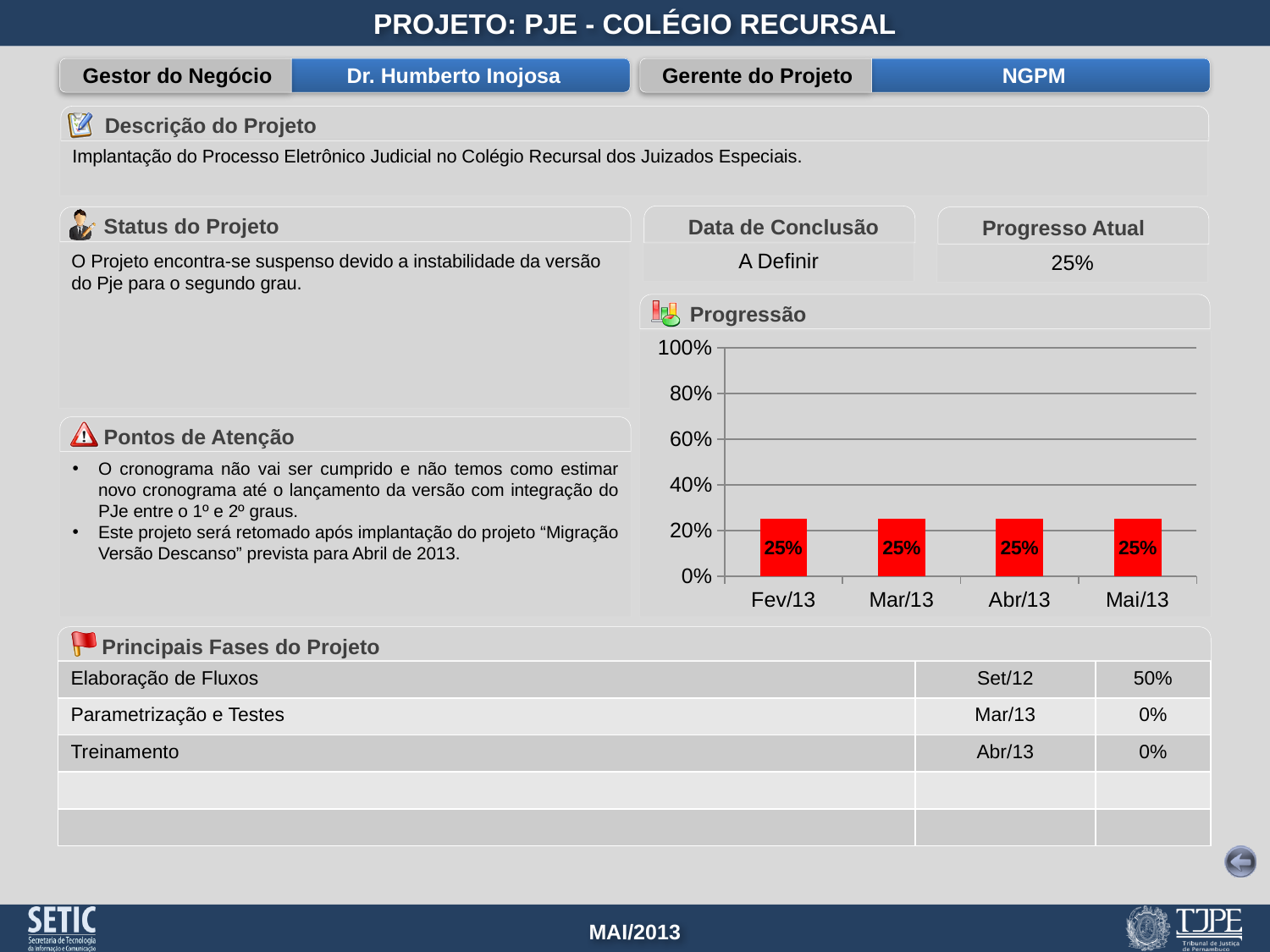
How many categories are shown on the x axis of the Progressão chart? 4 What is the highest value shown on the y axis of the Progressão chart? 100% What is the value for Fev/13 in the Progressão chart? 25% What is the value for Mai/13 in the Progressão chart? 25% What is the difference between the values for Fev/13 and Mar/13 in the Progressão chart? 0% What is the value for Abr/13 in the Progressão chart? 25% Is the value for Mar/13 in the Progressão chart greater or less than 40%? less Do the values in the Progressão chart rise, fall or stay flat from Fev/13 to Mai/13? stay flat What kind of chart is the Progressão chart? bar chart What colour are the bars in the Progressão chart? red What is the label of the first category on the x axis of the Progressão chart? Fev/13